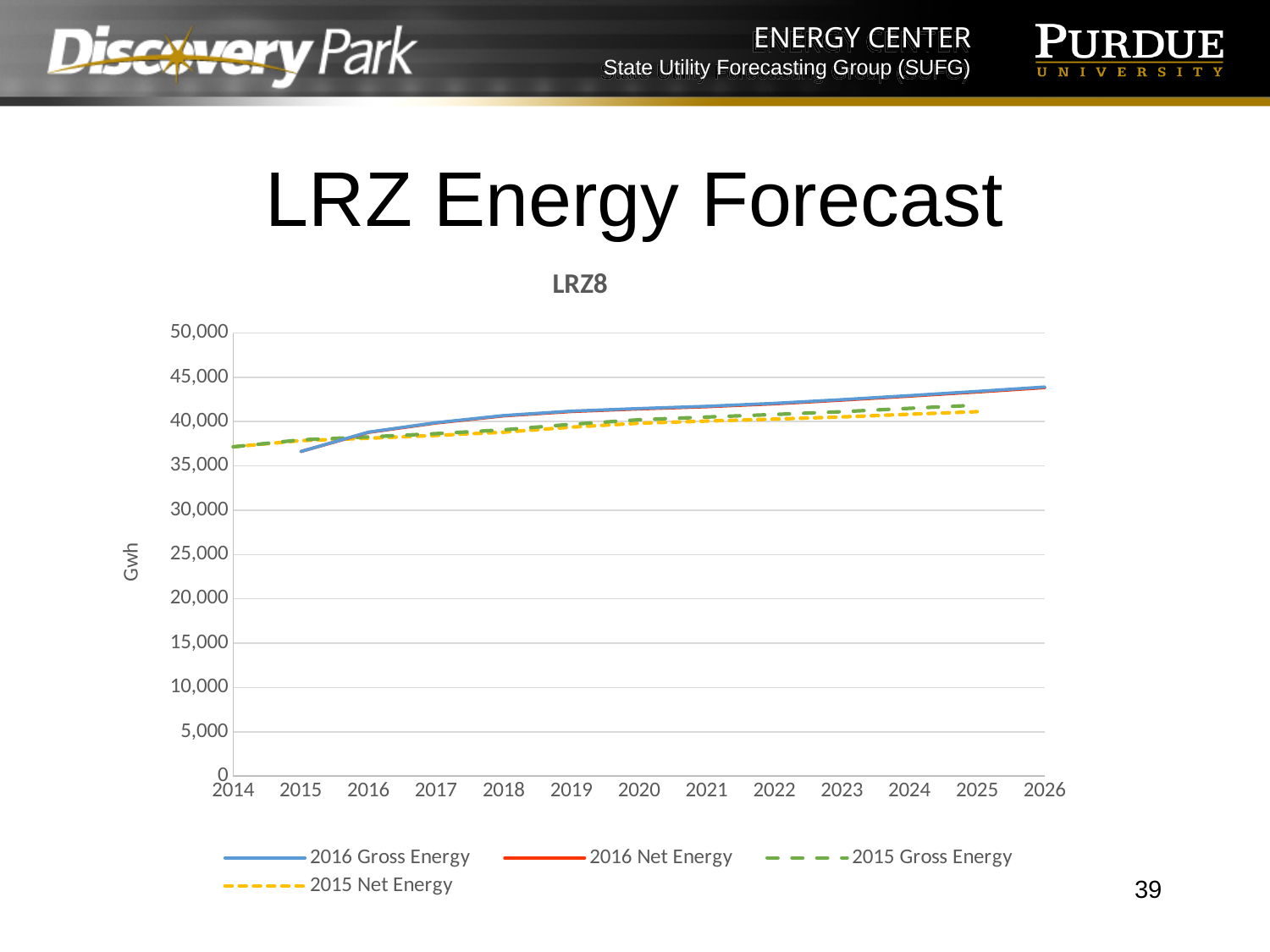
How many series does the legend of the LRZ8 chart list? 4 Does the 2015 Net Energy line rise or fall from 2014 to 2025? Rise How many years are labelled on the x-axis of the chart? 13 Does the 2016 Gross Energy line rise or fall from 2015 to 2026? Rise Is the value for 2016 Gross Energy in 2026 greater or less than 40,000? greater In 2015, which is larger: 2015 Gross Energy or 2016 Gross Energy? 2015 Gross Energy What kind of chart is shown on the slide? Line chart What is the title of the chart? LRZ8 In 2025, which is larger: 2016 Gross Energy or 2015 Gross Energy? 2016 Gross Energy What unit is shown on the y-axis of the chart? Gwh Is the value for 2016 Gross Energy in 2026 greater or less than 45,000? less Is the value for 2015 Gross Energy in 2014 greater or less than 40,000? less